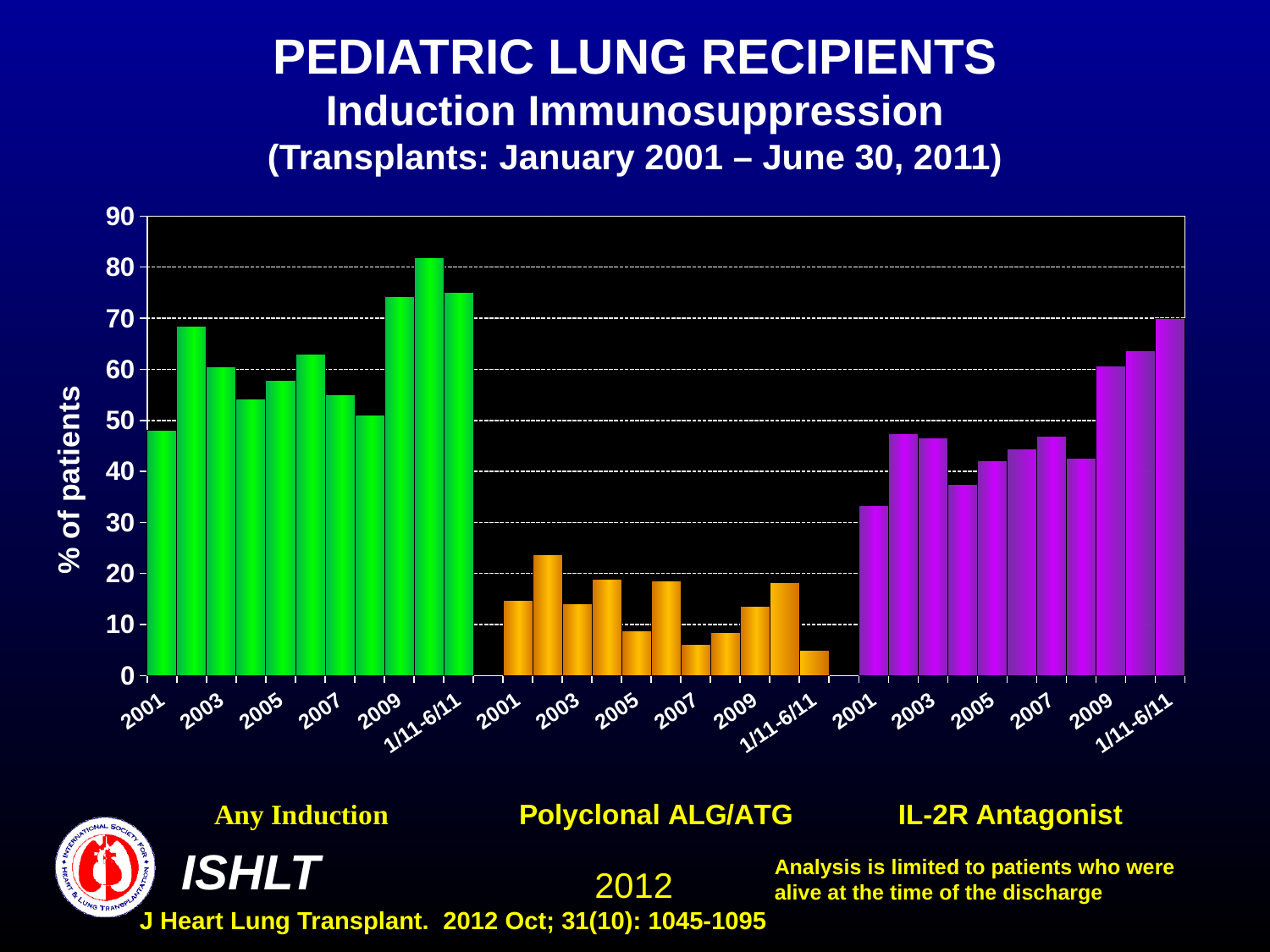
What kind of chart is shown on the slide? bar chart Is the Any Induction value for 2001 greater or less than 50? less In the Any Induction group, which period has the highest percentage of patients? 2010 Is the Polyclonal ALG/ATG value for 2007 greater or less than 10? less In the IL-2R Antagonist group, which period has the highest percentage of patients? 1/11-6/11 How many time periods are plotted for each induction group? 11 Which is larger: the IL-2R Antagonist value for 2009 or the Polyclonal ALG/ATG value for 2009? IL-2R Antagonist 2009 In the Polyclonal ALG/ATG group, which period has the lowest percentage of patients? 1/11-6/11 In the Polyclonal ALG/ATG group, which period has the highest percentage of patients? 2002 Is the Any Induction value for 2010 greater or less than 80? greater What is the label on the y axis? % of patients In the Any Induction group, which period has the lowest percentage of patients? 2001